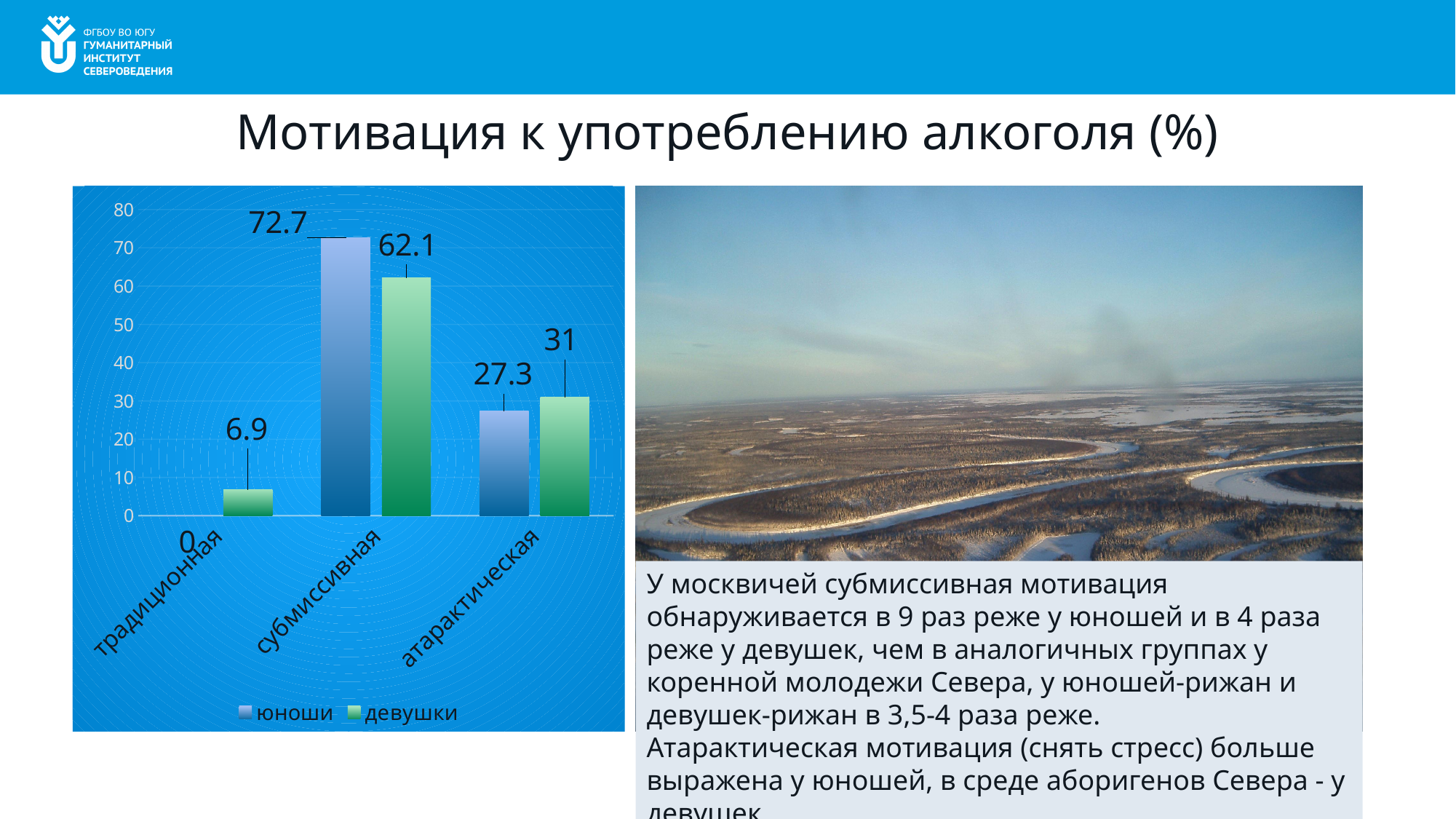
What is the value for юноши in the атарактическая category? 27.3 What is the value for девушки in the традиционная category? 6.9 In the атарактическая category, which series has the larger value, юноши or девушки? девушки How many categories are shown on the x axis of the chart? 3 Which category has the highest value for юноши? субмиссивная What is the value for девушки in the атарактическая category? 31 What is the value for юноши in the субмиссивная category? 72.7 What type of chart is shown on the slide? bar chart What is the difference between the юноши and девушки values in the субмиссивная category? 10.6 Which category has the lowest value for девушки? традиционная What is the value for девушки in the субмиссивная category? 62.1 How many series does the chart legend list? 2